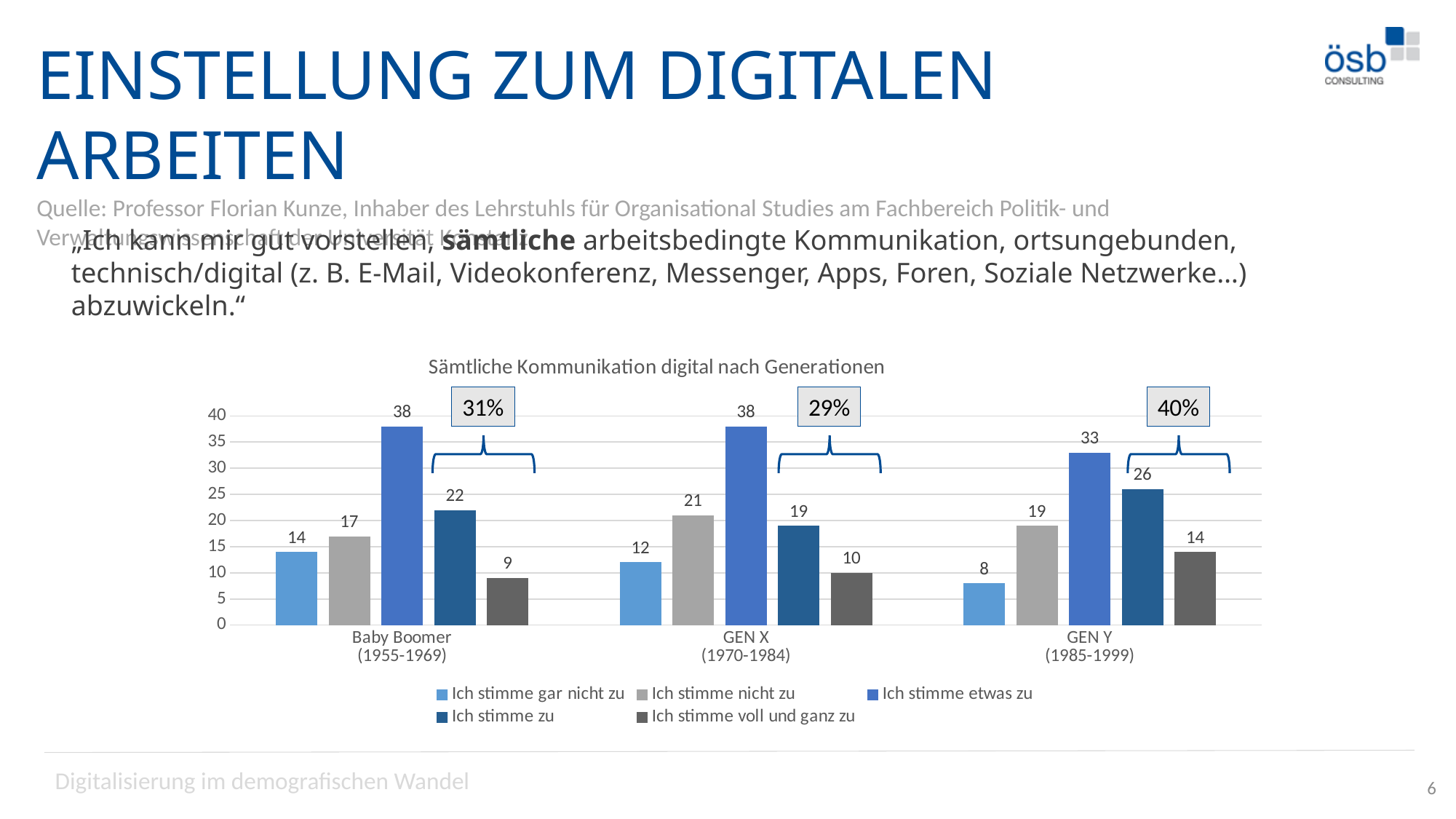
What percentage is shown in the box above the GEN Y (1985-1999) group? 40% What kind of chart is shown on the slide? Bar chart What is the value for "Ich stimme voll und ganz zu" in the GEN Y (1985-1999) group? 14 How many series does the legend list? 5 Which generation has the highest value for "Ich stimme zu"? GEN Y (1985-1999) What is the title of the chart? Sämtliche Kommunikation digital nach Generationen How many generation groups are shown on the x axis? 3 Which is larger in the GEN X (1970-1984) group: "Ich stimme nicht zu" or "Ich stimme zu"? Ich stimme nicht zu What is the difference between "Ich stimme nicht zu" and "Ich stimme gar nicht zu" in the Baby Boomer (1955-1969) group? 3 What is the value for "Ich stimme etwas zu" in the Baby Boomer (1955-1969) group? 38 Which generation has the lowest value for "Ich stimme gar nicht zu"? GEN Y (1985-1999) What is the value for "Ich stimme gar nicht zu" in the GEN X (1970-1984) group? 12